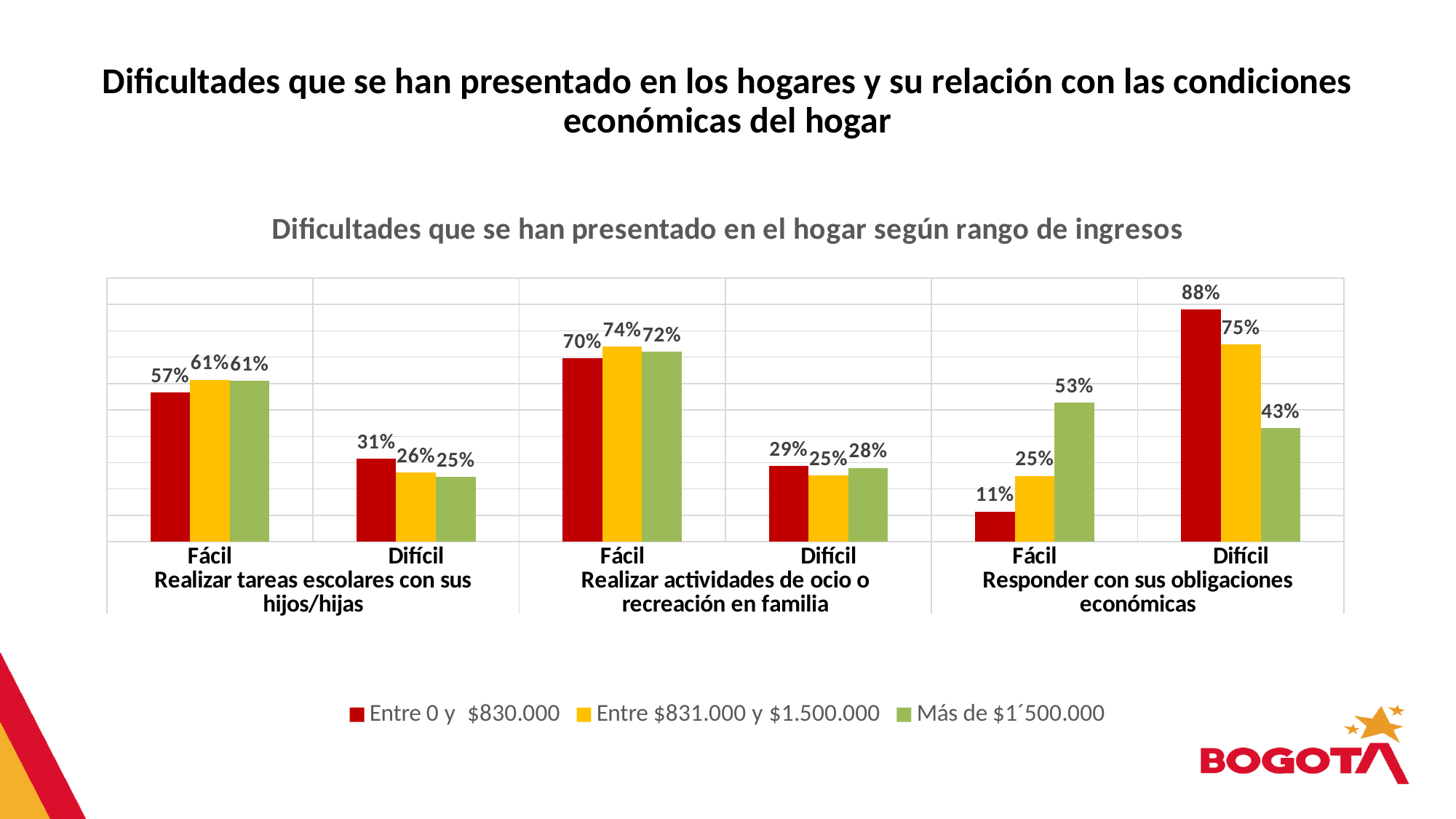
How many series does the legend list? 3 What is the difference between the 'Entre 0 y $830.000' and 'Más de $1´500.000' values for 'Difícil' under 'Responder con sus obligaciones económicas'? 45% Which category has the lowest value for the 'Entre 0 y $830.000' series? Fácil (Responder con sus obligaciones económicas) What kind of chart is shown on the slide? Bar chart What is the value for 'Entre $831.000 y $1.500.000' for 'Fácil' under 'Realizar actividades de ocio o recreación en familia'? 74% What is the value for 'Entre 0 y $830.000' for 'Difícil' under 'Realizar tareas escolares con sus hijos/hijas'? 31% What is the value for 'Más de $1´500.000' for 'Fácil' under 'Responder con sus obligaciones económicas'? 53% Which category has the highest value for the 'Entre 0 y $830.000' series? Difícil (Responder con sus obligaciones económicas) What colour represents the 'Más de $1´500.000' series? Green For 'Fácil' under 'Responder con sus obligaciones económicas', which series has the larger value: 'Entre 0 y $830.000' or 'Más de $1´500.000'? Más de $1´500.000 What is the value for 'Entre 0 y $830.000' for 'Difícil' under 'Responder con sus obligaciones económicas'? 88% What is the title of the chart? Dificultades que se han presentado en el hogar según rango de ingresos